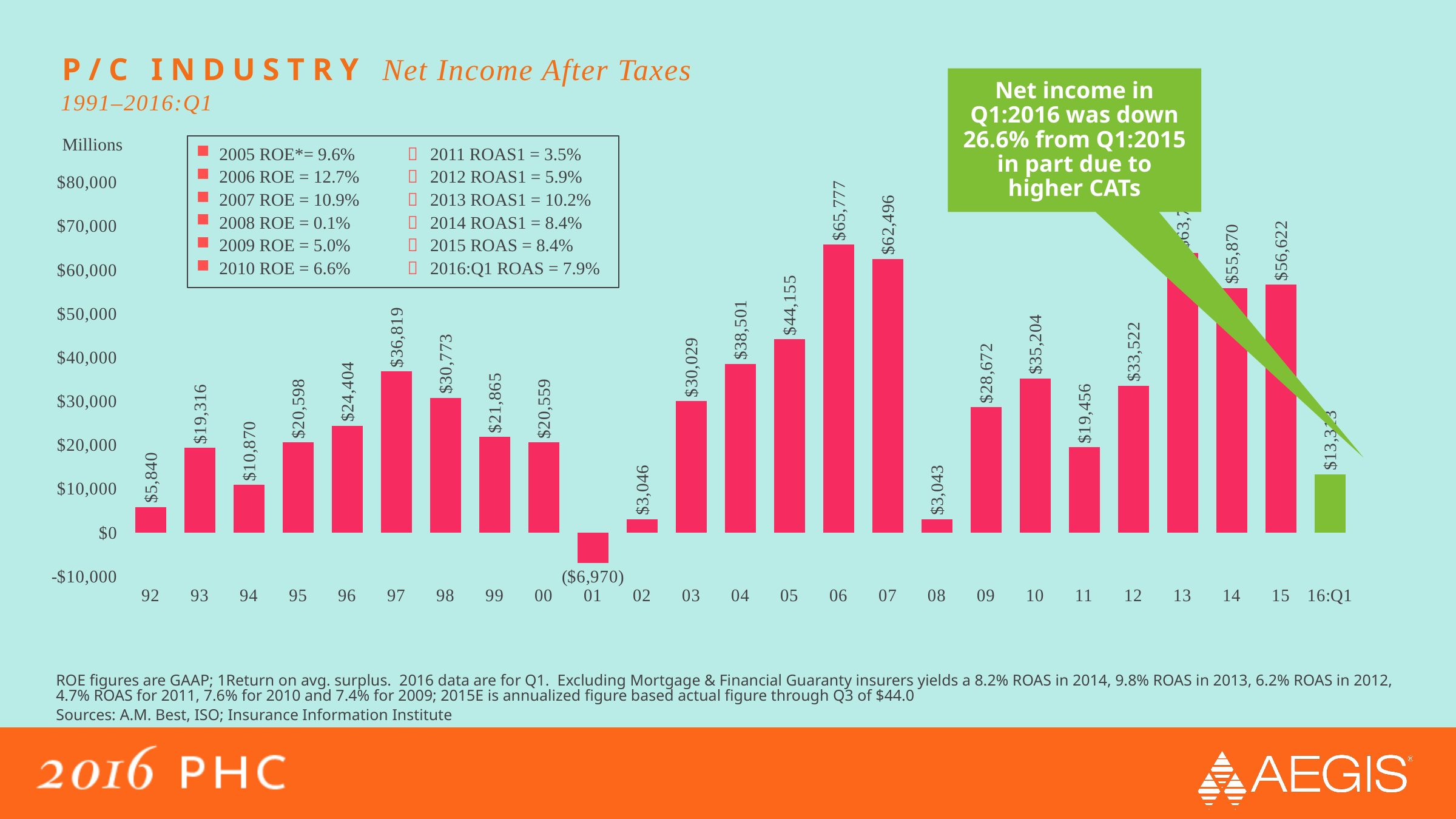
How many bars are plotted on the chart? 25 What kind of chart is shown? bar chart Which year has the lowest net income after taxes? 01 What was the P/C industry net income after taxes in 2006? $65,777 Do the values rise or fall from 2003 to 2006? rise What is the difference between the 2006 and 2007 values? $3,281 Which year has the highest net income after taxes? 06 What was net income after taxes in 2015? $56,622 What unit is indicated for the y axis? Millions Which is larger, the value for 2004 or the value for 2005? 2005 Is the value for 2009 greater or less than $20,000? greater What value is shown for 2001? ($6,970)